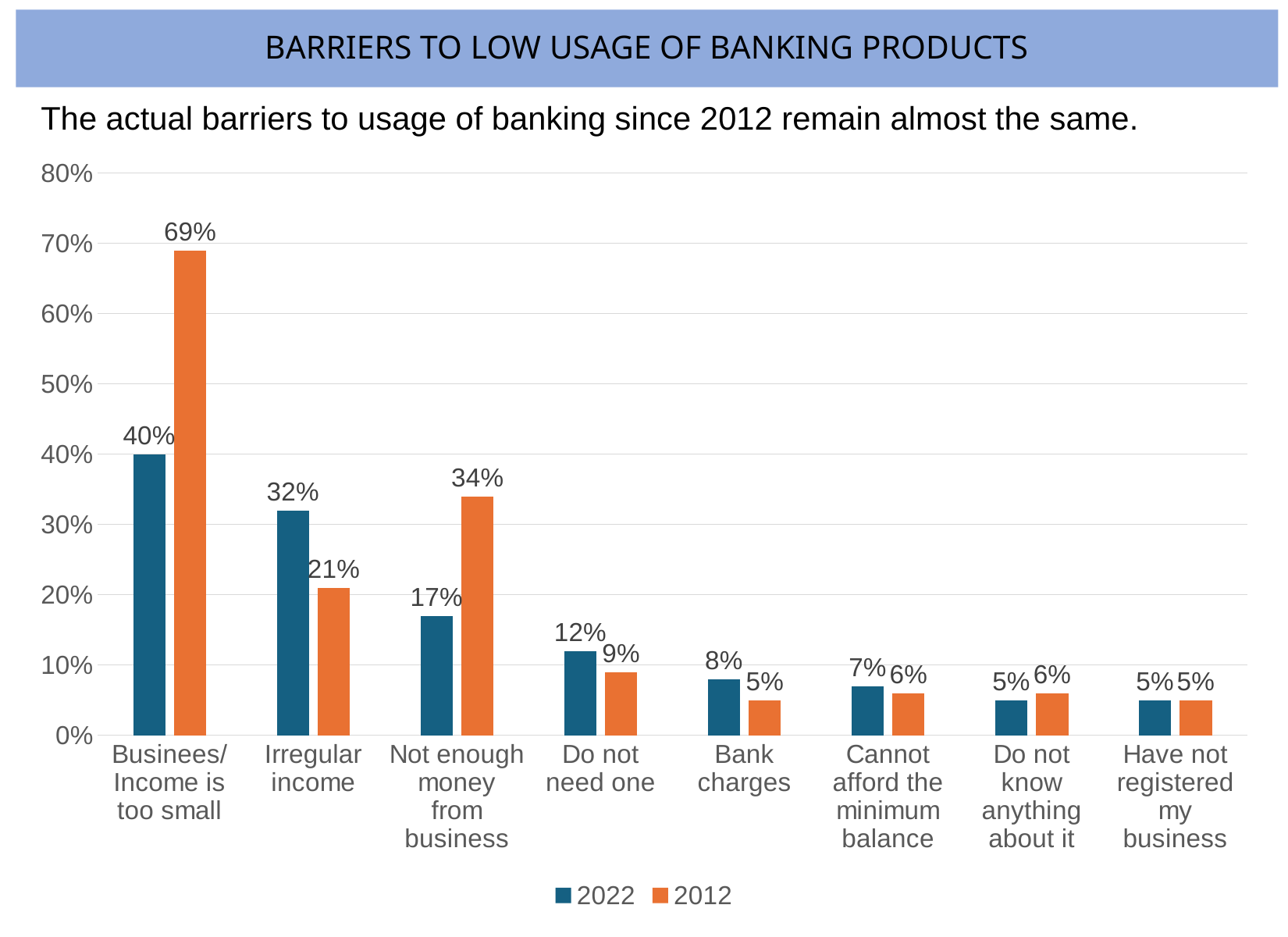
What is the 2022 value for "Irregular income"? 32% What is the 2022 value for "Do not need one"? 12% Which is larger for "Irregular income": the 2022 value or the 2012 value? 2022 Which category has the lowest 2012 value? Bank charges and Have not registered my business (both 5%) What is the title of the slide? BARRIERS TO LOW USAGE OF BANKING PRODUCTS What is the difference between the 2012 and 2022 values for "Businees/Income is too small"? 29% Which category has the highest 2022 value? Businees/Income is too small How many categories are shown on the x axis? 8 How many series does the legend list? 2 What is the 2012 value for "Not enough money from business"? 34% What is the 2012 value for "Businees/Income is too small"? 69% What kind of chart is shown on the slide? Bar chart